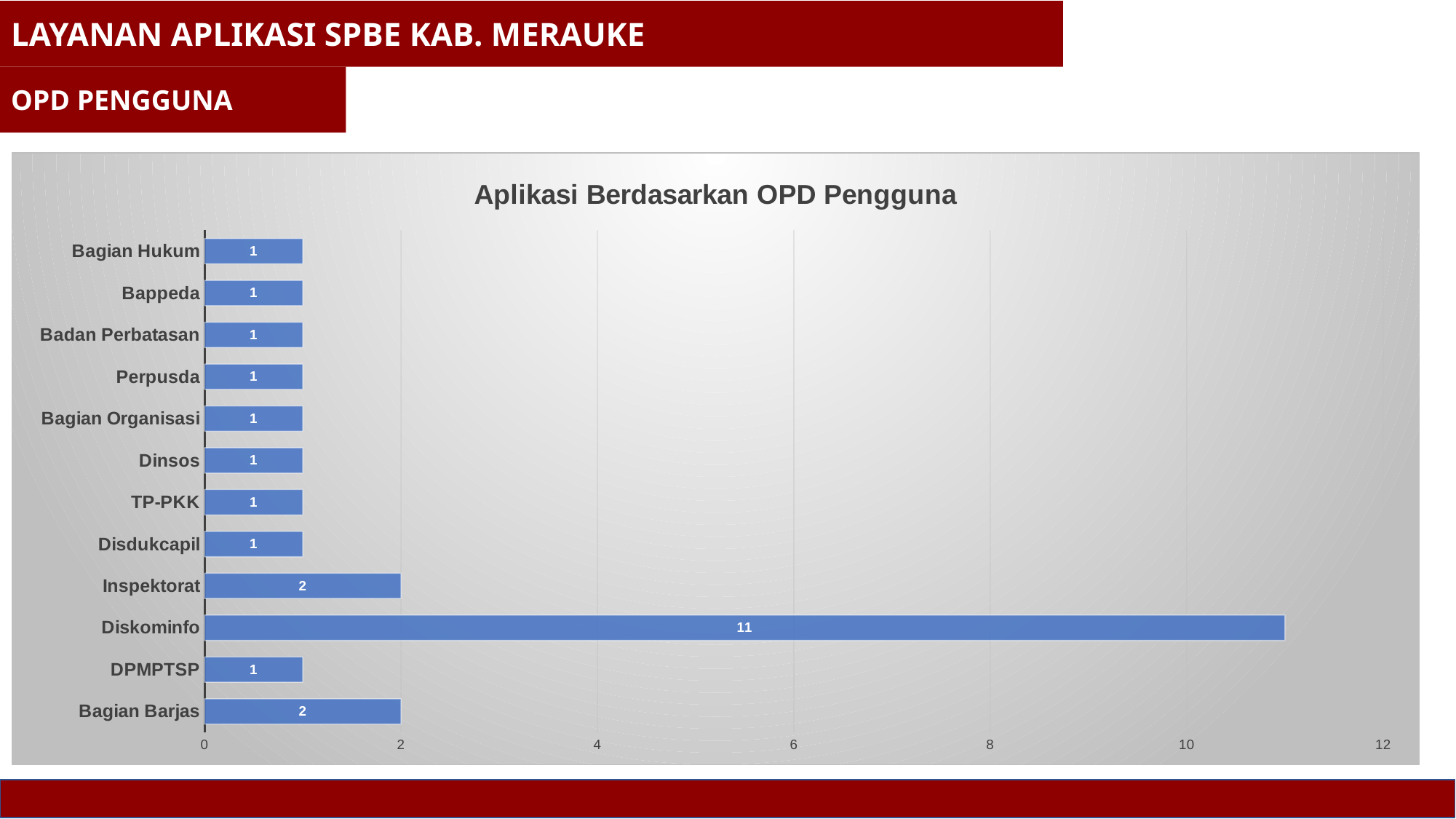
What is the title of the chart? Aplikasi Berdasarkan OPD Pengguna What is the value for Inspektorat? 2 What kind of chart is shown on the slide? Bar chart Is the value for Diskominfo greater or less than 10? greater What is the value for Bappeda? 1 What is the difference between the values for Diskominfo and Inspektorat? 9 How many OPD categories are shown in the chart? 12 What is the value for Bagian Barjas? 2 Which OPD has the highest value? Diskominfo Which is larger, the value for Inspektorat or the value for Disdukcapil? Inspektorat What is the difference between the values for Bagian Barjas and DPMPTSP? 1 What is the value for Diskominfo? 11